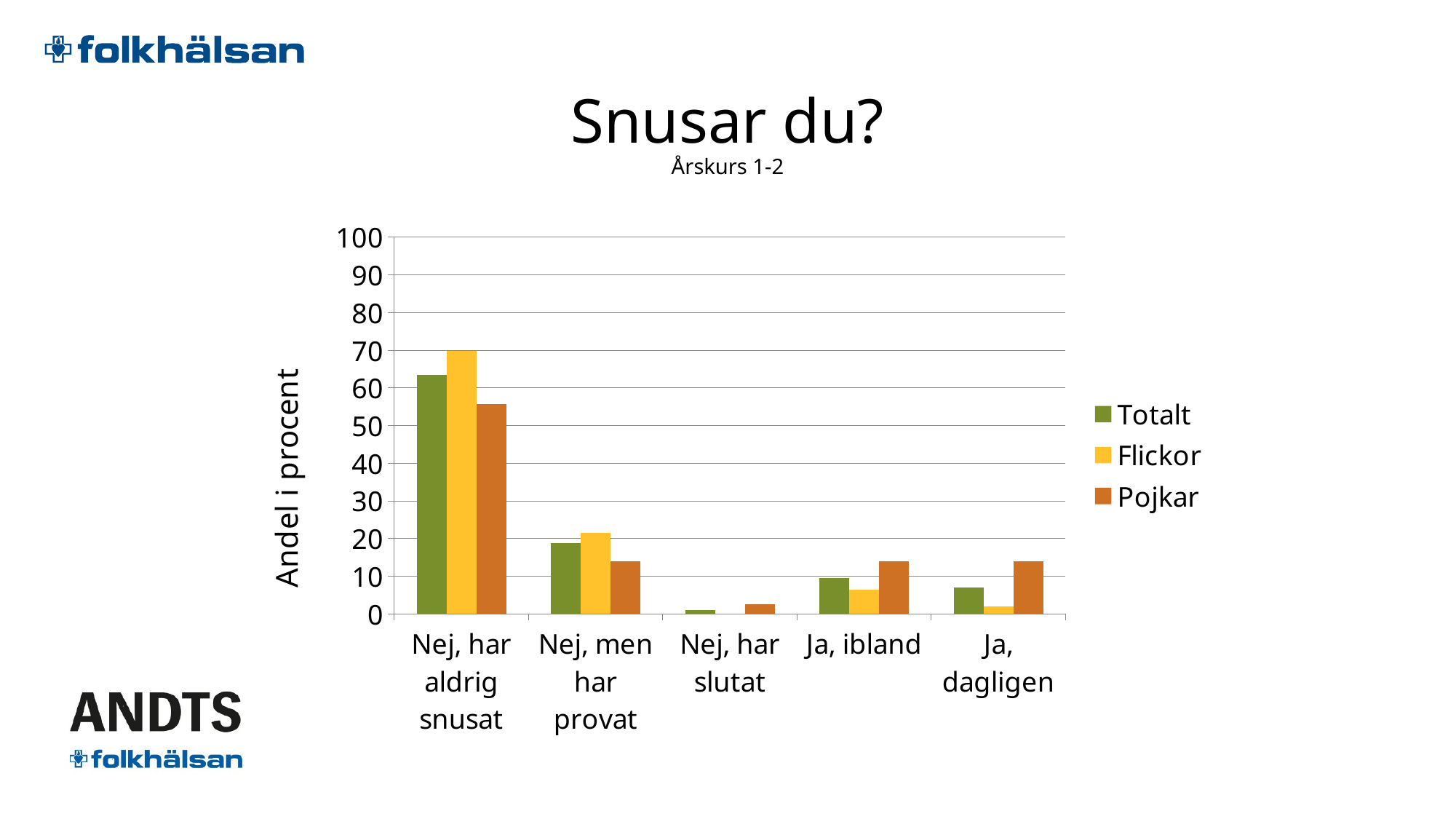
What is the label of the y axis? Andel i procent Which category has the lowest value for Pojkar? Nej, har slutat In 'Ja, dagligen', which is larger, Flickor or Pojkar? Pojkar Is the value for Pojkar in 'Nej, men har provat' greater or less than 20? less What is the title of the chart? Snusar du? Is the value for Totalt in 'Ja, ibland' greater or less than 20? less How many categories are shown on the x axis? 5 What kind of chart is shown on the slide? bar chart How many series does the legend list? 3 Is the value for Flickor in 'Nej, har aldrig snusat' greater or less than 60? greater In 'Nej, har aldrig snusat', which is larger, Flickor or Pojkar? Flickor Which category has the highest value for Totalt? Nej, har aldrig snusat